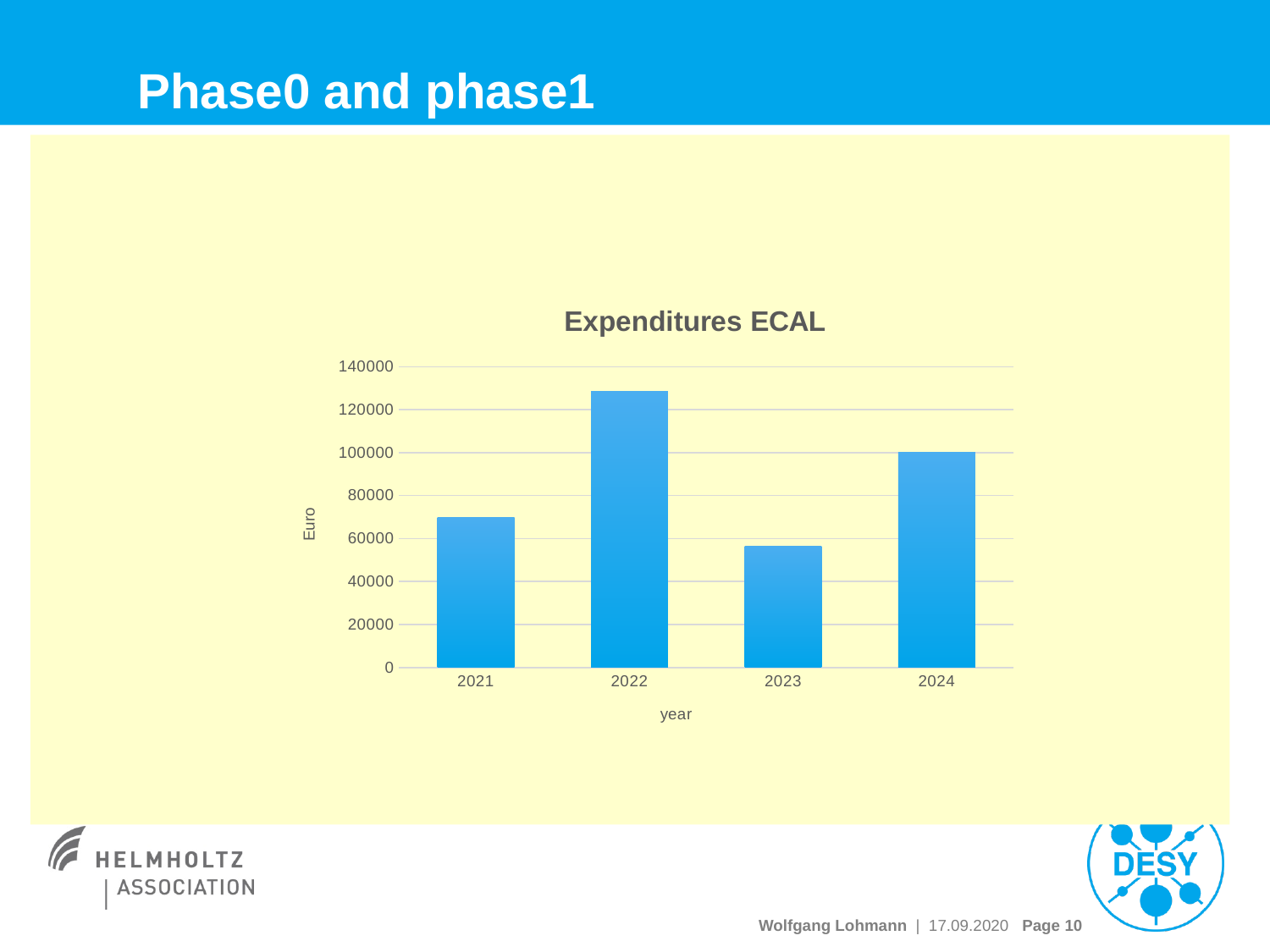
Which year has the larger expenditure, 2024 or 2022? 2022 How many years are shown on the x axis of the chart? 4 Which year has the larger expenditure, 2021 or 2023? 2021 Which year has the highest expenditure? 2022 What is the title of the chart? Expenditures ECAL What kind of chart is shown on the slide? bar chart Is the value for 2021 greater or less than 80000? less Is the value for 2022 greater or less than 120000? greater What is the label of the vertical axis? Euro Is the value for 2021 greater or less than 60000? greater Which year has the lowest expenditure? 2023